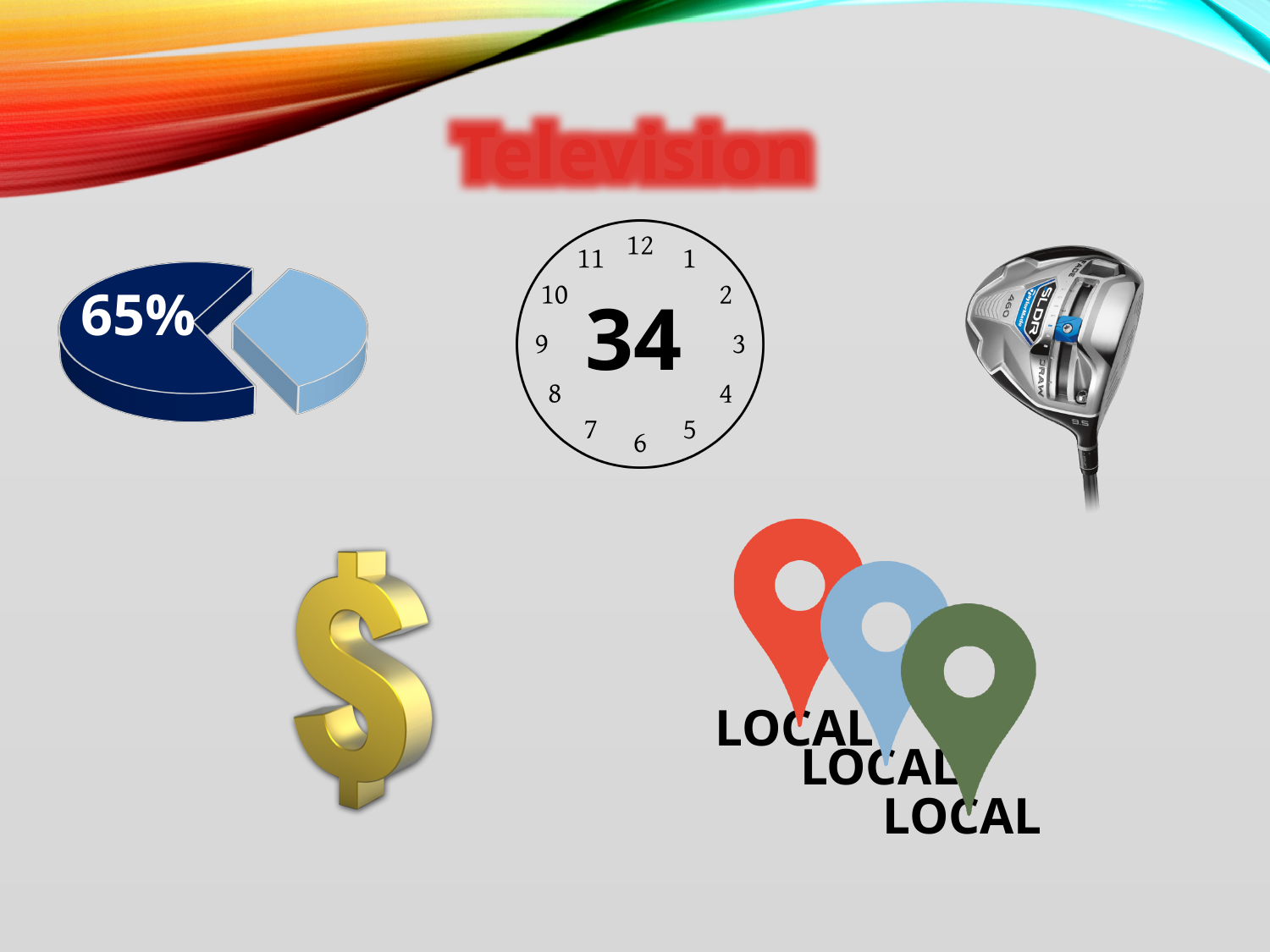
What percentage is printed on the dark blue slice of the pie chart? 65% How many slices does the pie chart have? 2 Which slice of the pie chart is the largest? the dark blue slice Does the pie chart have a legend? No What share of the pie does the dark blue slice represent? 65% What kind of chart is shown on the left of the slide? pie chart Which slice of the pie chart is larger, the dark blue one or the light blue one? dark blue What colour is the slice of the pie chart that is pulled out from the rest? light blue Is the dark blue slice of the pie chart greater or less than 50% of the pie? greater